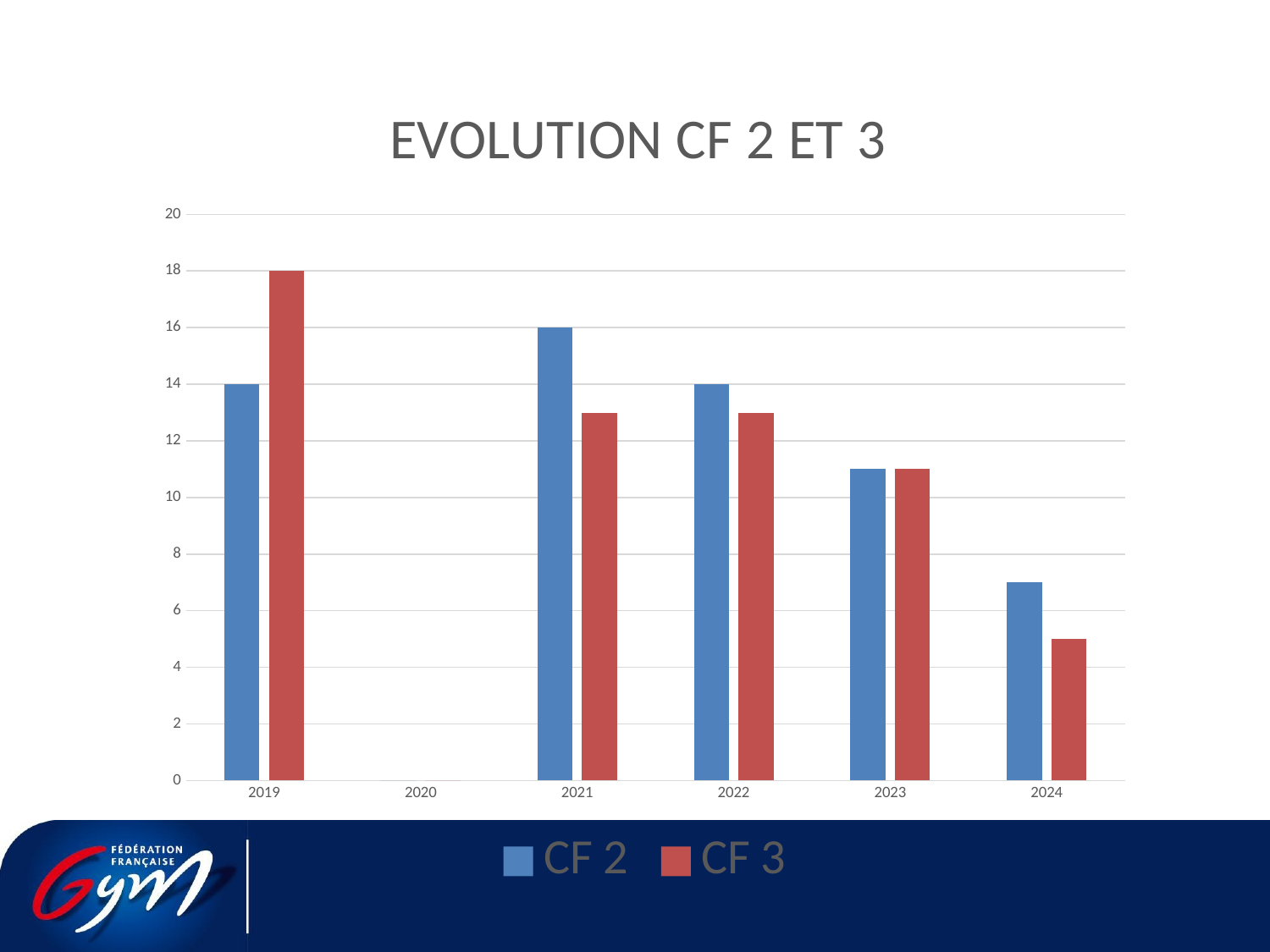
In which year is the CF 3 bar highest? 2019 How many years are shown on the x axis? 6 Is the value for CF 2 in 2023 greater or less than 10? greater What is the difference between CF 3 and CF 2 in 2019? 4 What is the value for CF 2 in 2021? 16 What kind of chart is shown on the slide? bar chart How many series does the legend list? 2 What is the value for CF 2 in 2019? 14 In 2021, which series has the larger value, CF 2 or CF 3? CF 2 What is the value for CF 3 in 2019? 18 Is the value for CF 3 in 2024 greater or less than 6? less